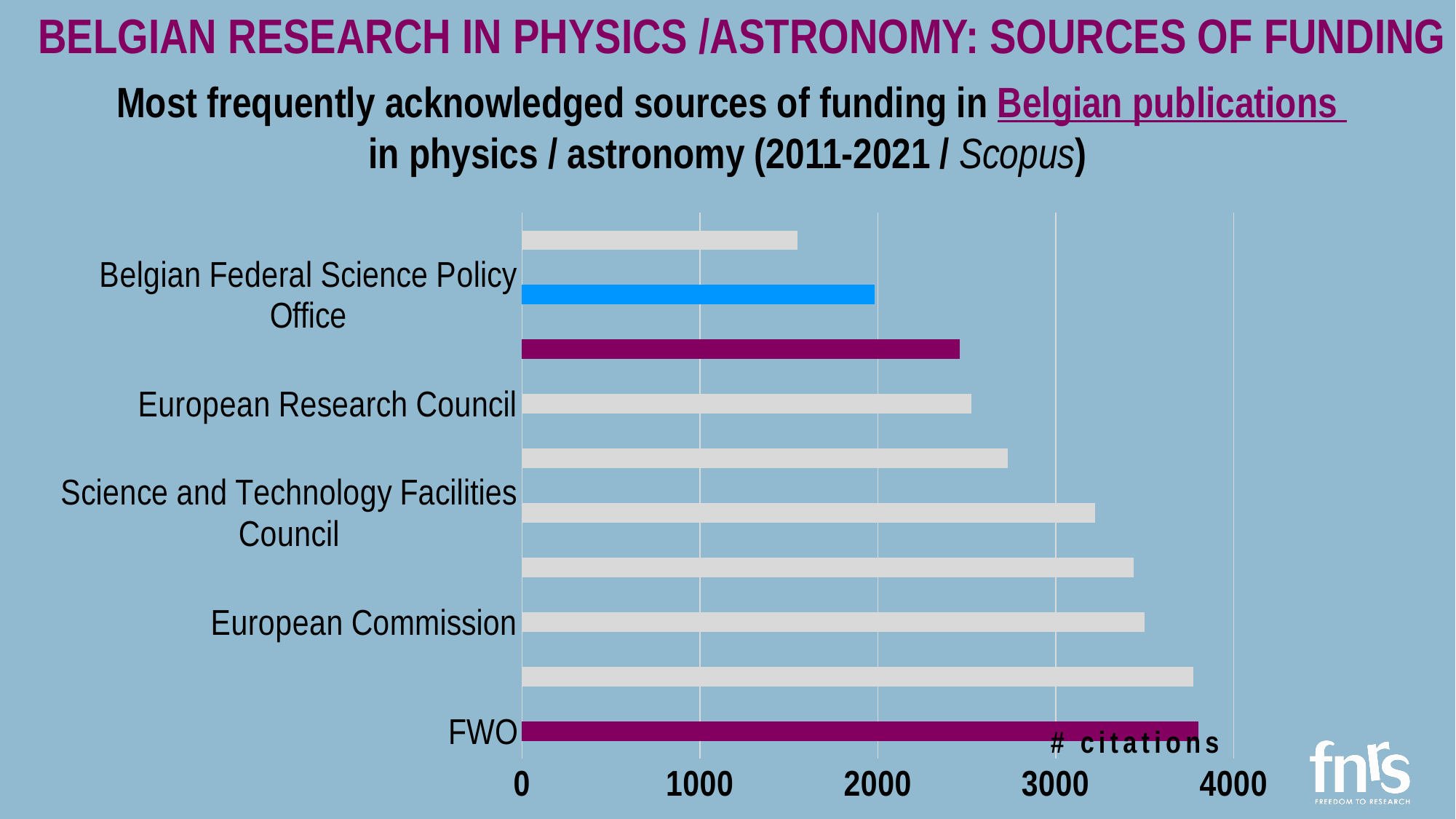
What kind of chart is shown on the slide? bar chart How many category labels are shown on the vertical axis of the chart? 5 Which of the labeled categories has the lowest value? Belgian Federal Science Policy Office What label is shown on the horizontal axis of the chart? # citations Is the value for FWO greater or less than 3000? greater Is the value for FWO greater or less than 4000? less Which is larger, the value for FWO or the value for European Commission? FWO Is the value for Belgian Federal Science Policy Office greater or less than 1000? greater Which is larger, the value for European Research Council or the value for Science and Technology Facilities Council? Science and Technology Facilities Council How many bars are plotted in the chart? 10